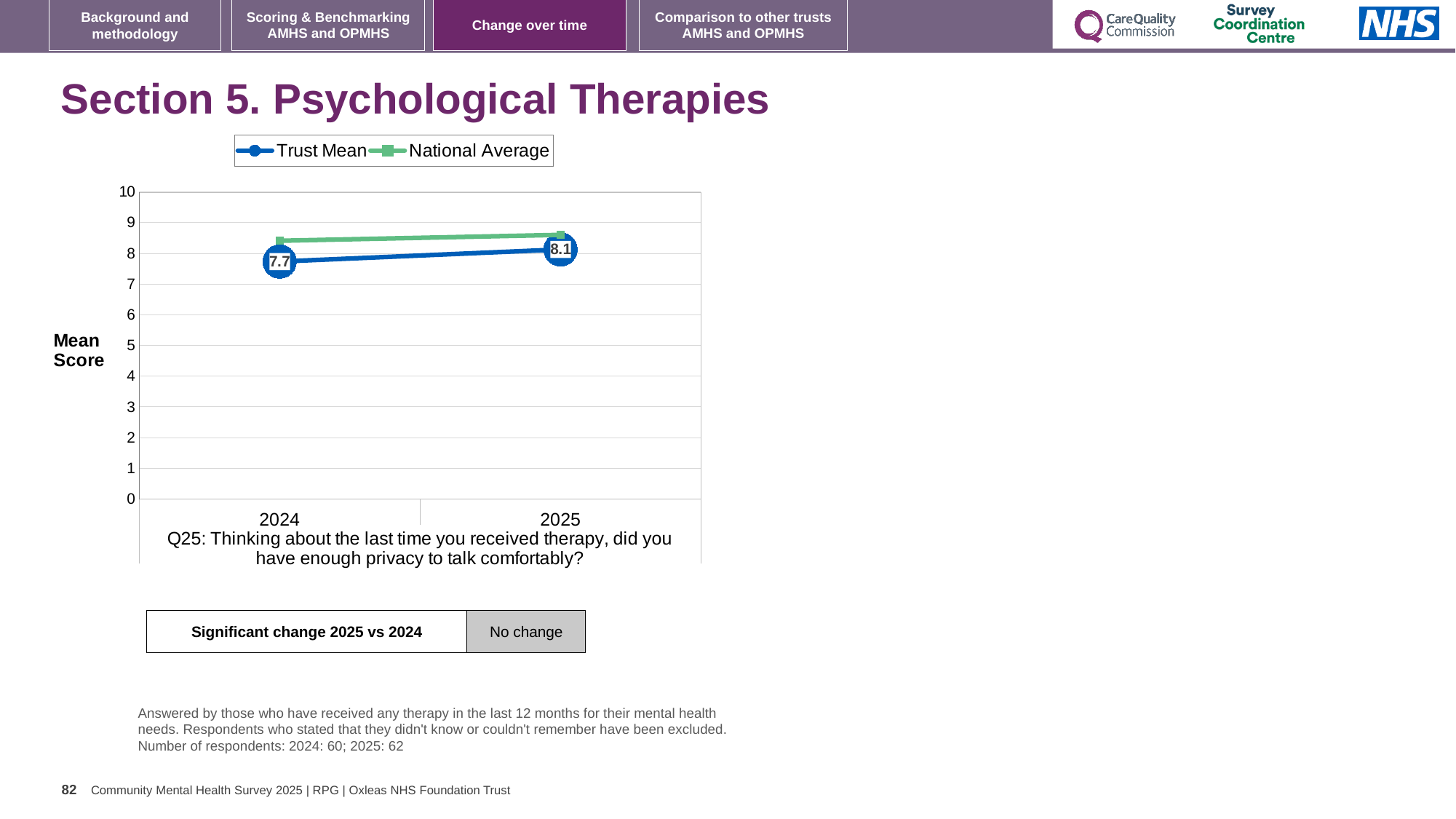
What is the Trust Mean score for 2024? 7.7 Does the Trust Mean rise or fall from 2024 to 2025? Rise How many years are shown on the x axis of the chart? 2 In 2024, which is higher: the Trust Mean or the National Average? National Average Is the National Average value for 2024 greater or less than 8? greater Is the Trust Mean value for 2024 greater or less than 8? less What is the Trust Mean score for 2025? 8.1 In which year is the Trust Mean score lowest? 2024 In which year is the Trust Mean score highest? 2025 How many series does the chart legend list? 2 What kind of chart is shown on the slide? Line chart By how much did the Trust Mean score change from 2024 to 2025? 0.4